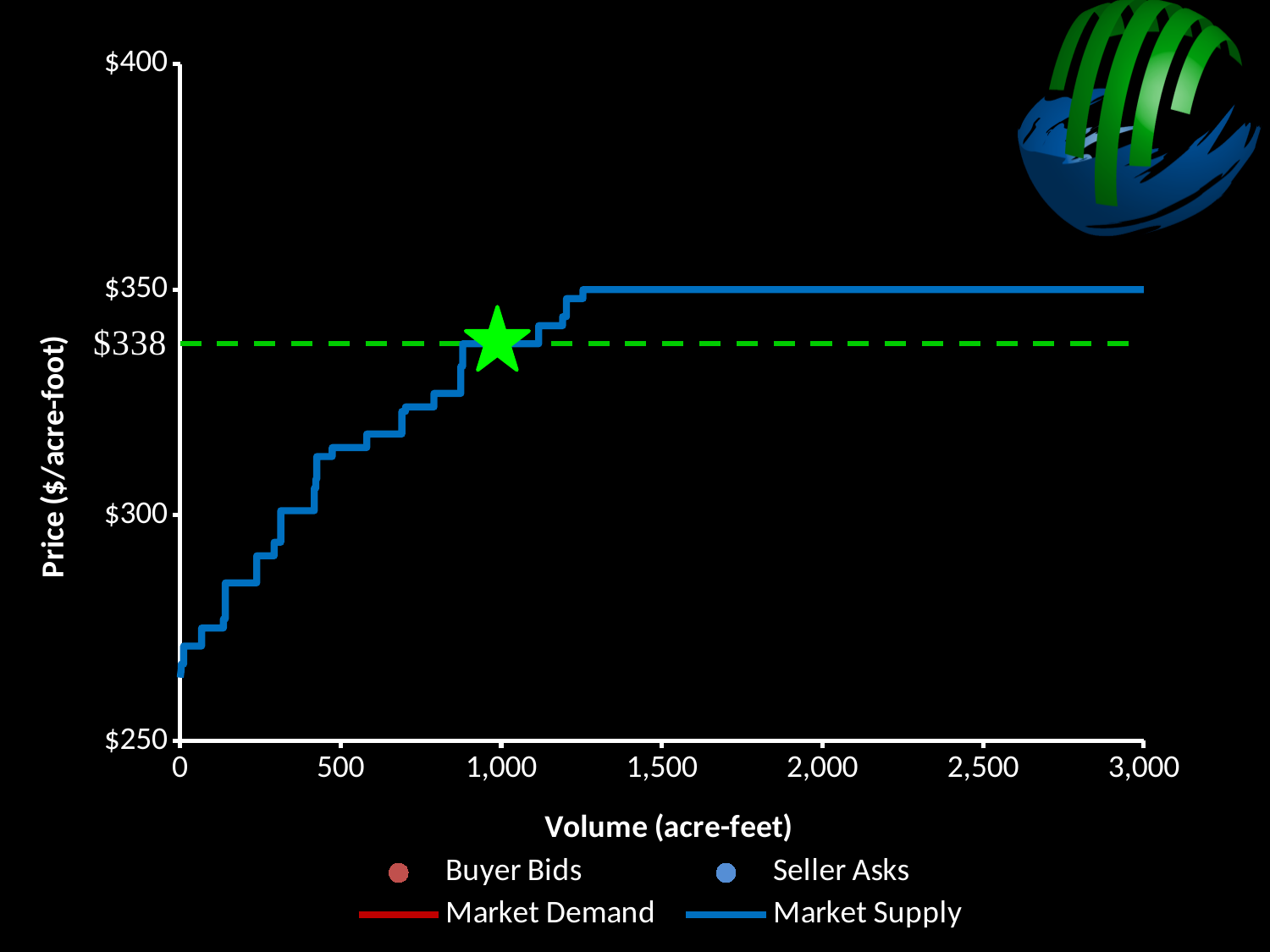
Which is higher: the Market Supply price at 500 acre-feet or at 1,500 acre-feet? 1,500 acre-feet Which legend entry is drawn as a blue line? Market Supply How many entries does the legend list? 4 Is the Market Supply price at a volume of 2,000 acre-feet greater or less than $338? greater At what price does the Market Supply curve level off for volumes above about 1,250 acre-feet? $350 What price level does the green dashed horizontal line mark? $338 What is the title of the x axis? Volume (acre-feet) Does the Market Supply curve rise or fall as volume increases from 0 to 1,000 acre-feet? rise What kind of chart is shown on the slide? line chart Is the Market Supply price at a volume of 0 acre-feet greater or less than $300? less Is the Market Supply price at a volume of 3,000 acre-feet greater or less than $300? greater